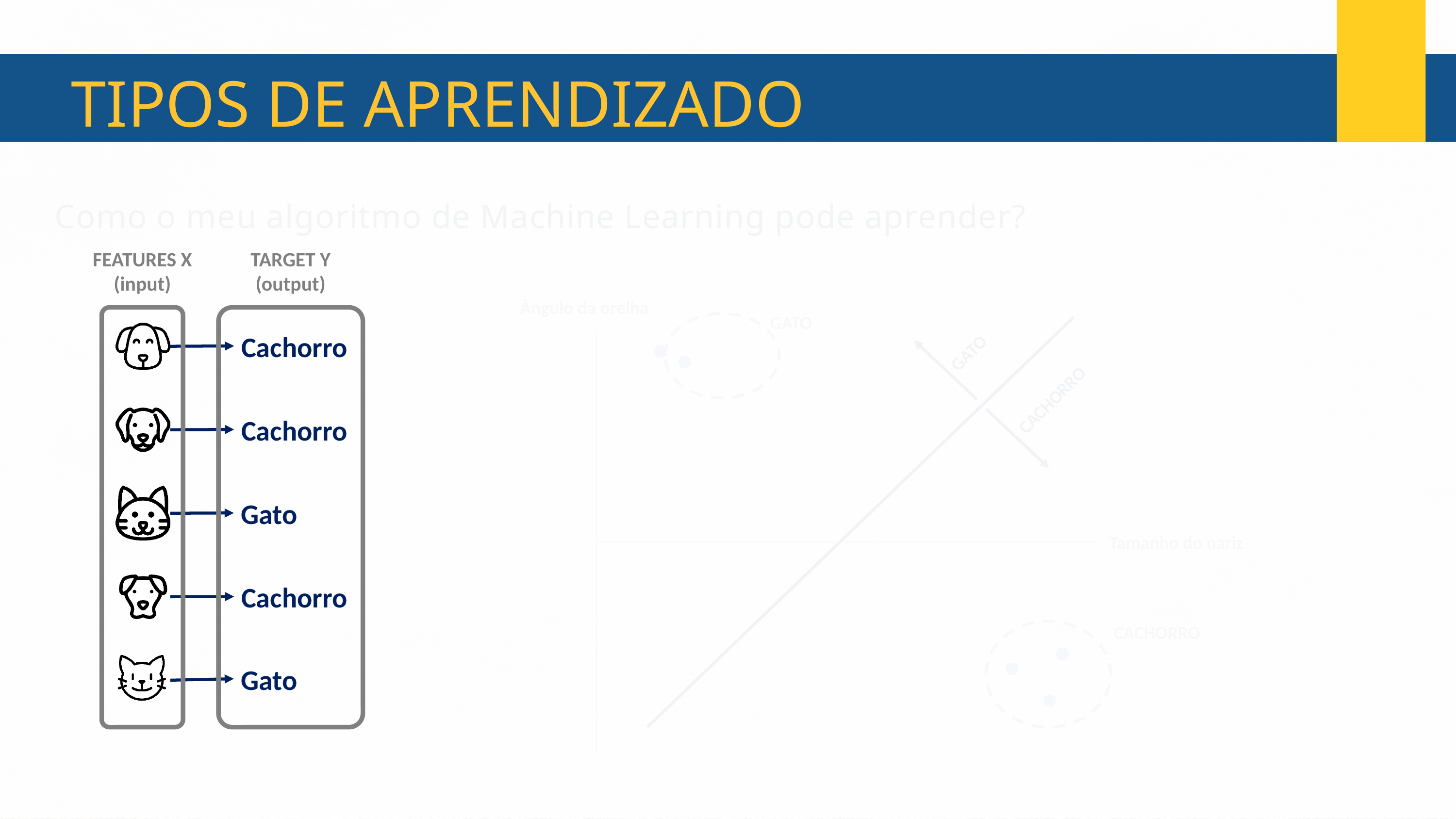
What is the heading of the left column of the diagram? FEATURES X (input) What is the target label for the first (top) example in the diagram? Cachorro What is the target label for the third example from the top? Gato How many of the examples have the target label "Gato"? 2 How many input examples are shown in the FEATURES X (input) column? 5 How many of the examples have the target label "Cachorro"? 3 What is the heading of the right column of the diagram? TARGET Y (output) What is the target label for the last (bottom) example in the diagram? Gato